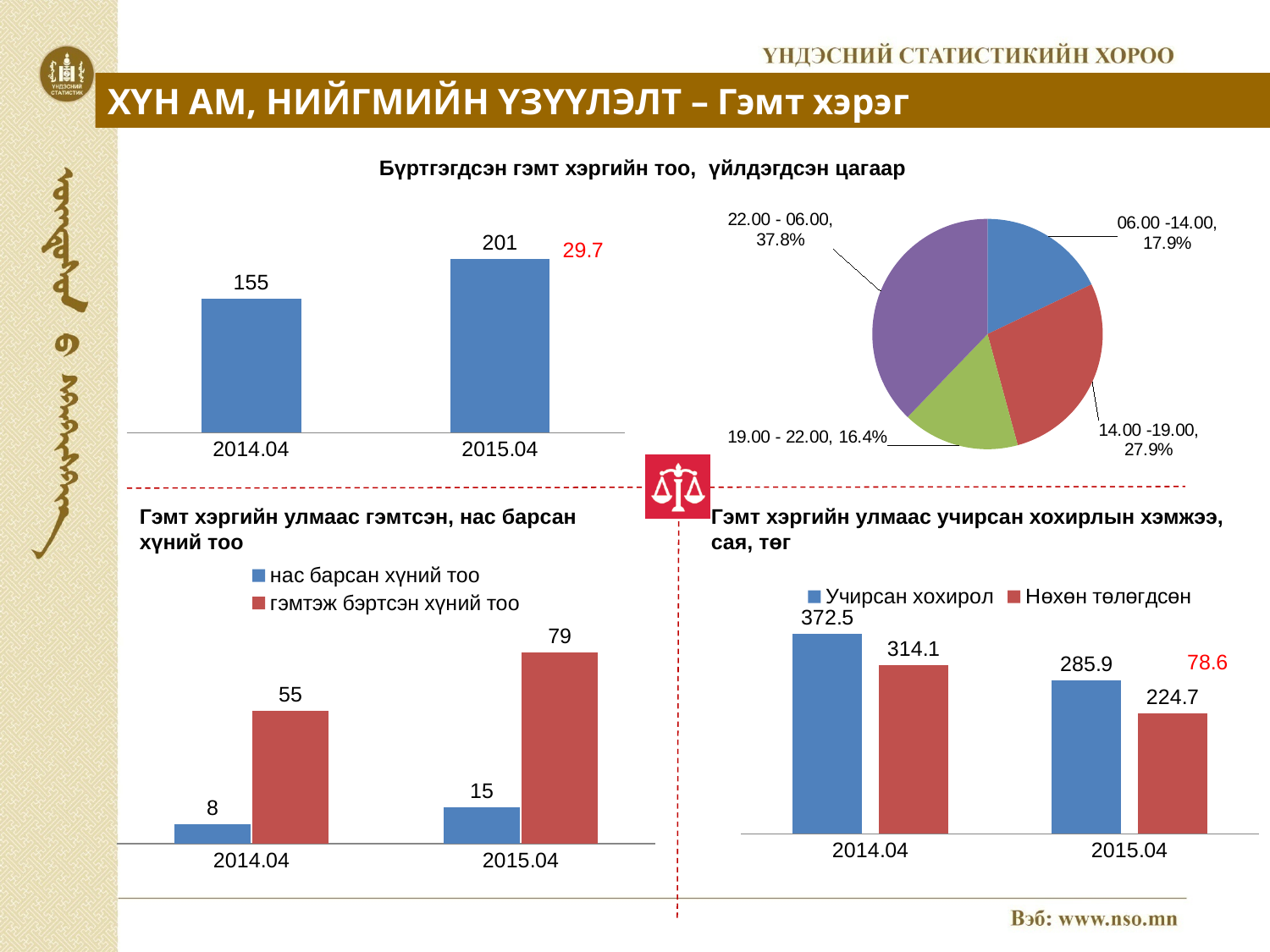
How many slices does the top-right pie chart have? 4 What kind of chart is the top-right chart on the slide? pie chart How many series does the legend of the bottom-left bar chart list? 2 In the bottom-left bar chart, what is the value for нас барсан хүний тоо in 2014.04? 8 In the top-left bar chart, what is the value for 2014.04? 155 In the bottom-right bar chart, which is larger in 2015.04: Учирсан хохирол or Нөхөн төлөгдсөн? Учирсан хохирол In the top-left bar chart, what is the value for 2015.04? 201 In the top-right pie chart, what share does the 22.00 - 06.00 slice have? 37.8% In the bottom-left bar chart, what is the value for гэмтэж бэртсэн хүний тоо in 2015.04? 79 In the top-left bar chart, what is the difference between the 2015.04 and 2014.04 values? 46 In the bottom-right bar chart, what is the value for Нөхөн төлөгдсөн in 2014.04? 314.1 In the top-right pie chart, which time period has the smallest share? 19.00 - 22.00